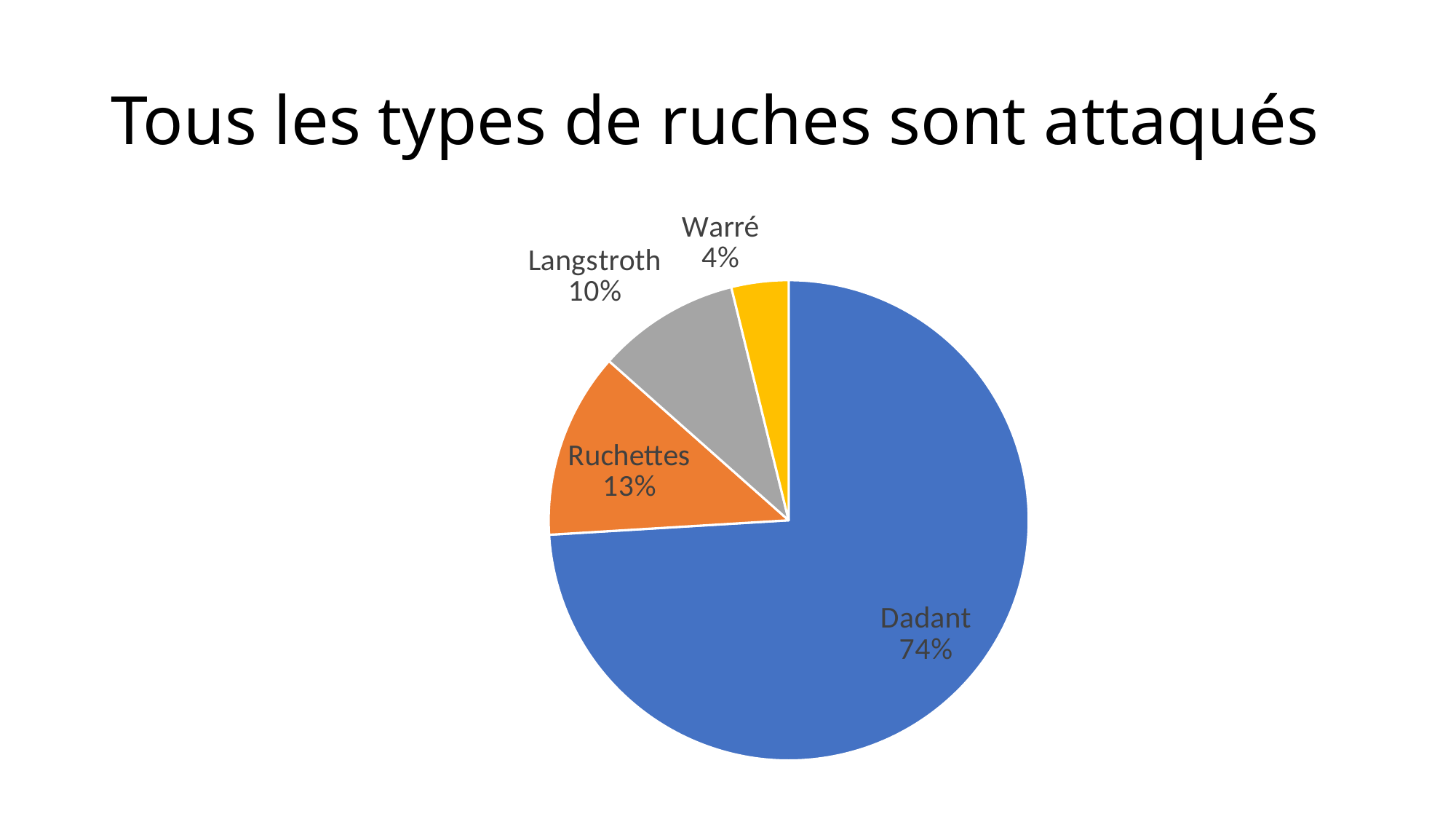
What is the difference in percentage points between Dadant and Ruchettes? 61 What is the difference in percentage points between Langstroth and Warré? 6 What share of the pie does Warré represent? 4% Which hive type has the smallest slice of the pie? Warré What kind of chart is shown on the slide? Pie chart How many slices does the pie chart have? 4 What share of the pie does Langstroth represent? 10% Which hive type has the largest slice of the pie? Dadant What share of the pie does Ruchettes represent? 13% What is the title of the slide? Tous les types de ruches sont attaqués Which is larger, the share for Ruchettes or the share for Langstroth? Ruchettes